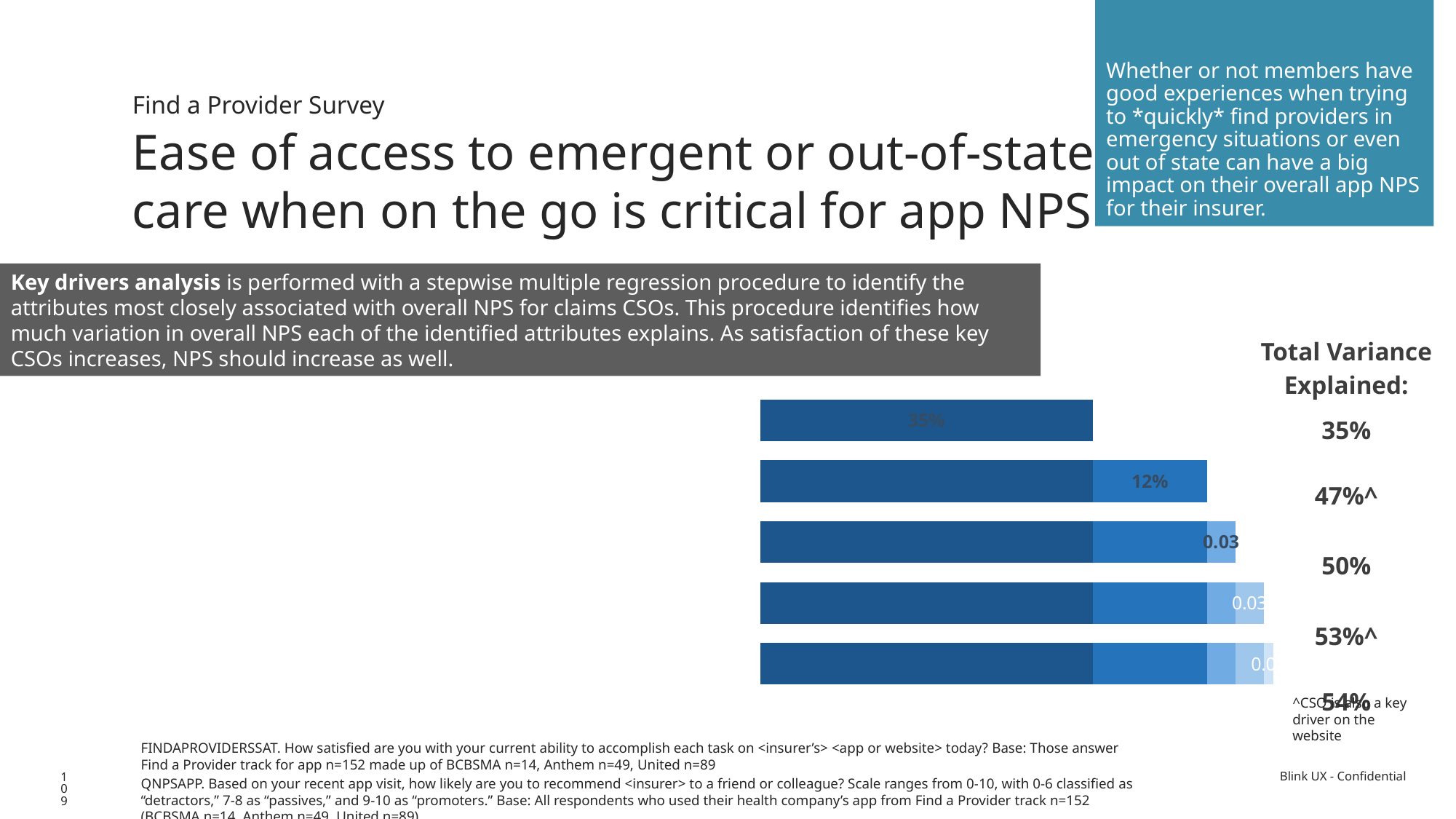
Which bar is the longest in the chart, the top bar or the bottom bar? bottom bar What value is labelled on the fourth segment of the fourth bar from the top? 0.03 How many bars are plotted in the chart? 5 What kind of chart is shown on the slide? bar chart What is the Total Variance Explained value listed for the second bar from the top? 47%^ Do the bar lengths increase or decrease going from the top bar to the bottom bar? increase What value is labelled on the first (top) bar of the chart? 35% What is the heading of the column of values to the right of the chart? Total Variance Explained: What value is labelled on the second segment of the second bar from the top? 12% What is the Total Variance Explained value listed for the first (top) bar? 35% Which bar is the shortest in the chart? the top bar What value is labelled on the third segment of the third bar from the top? 0.03